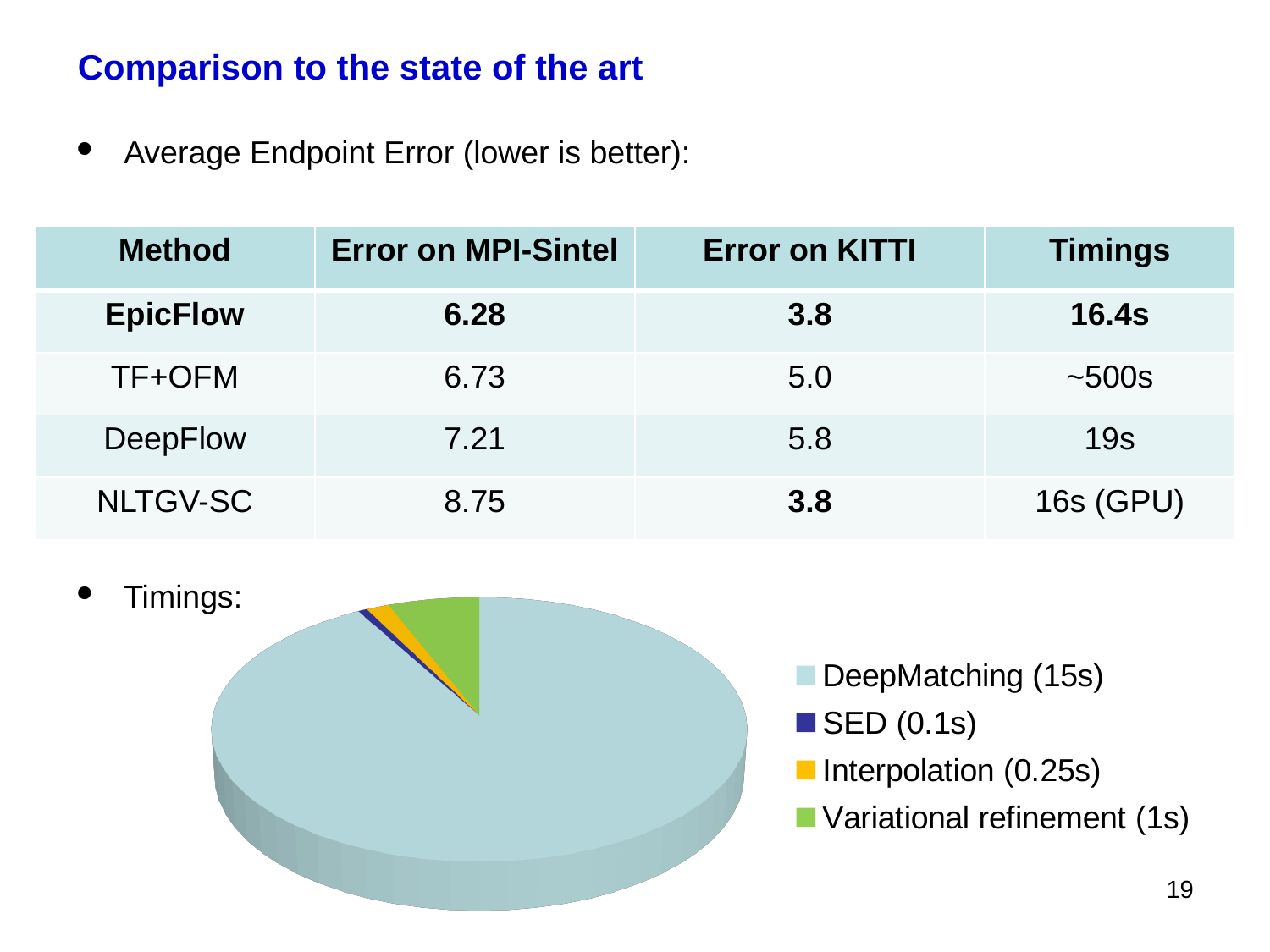
In the timings pie chart, how many slices (categories) does the legend list? 4 What kind of chart is shown under "Timings:" on the slide? pie chart In the timings pie chart, what is the time given for DeepMatching? 15s In the timings pie chart, what is the time given for Variational refinement? 1s In the timings pie chart, what is the time given for SED? 0.1s In the timings pie chart, what is the time given for Interpolation? 0.25s In the timings pie chart, which component takes the most time? DeepMatching In the timings pie chart, which legend entry is shown in green? Variational refinement (1s) In the timings pie chart, what colour is the DeepMatching slice? light blue In the timings pie chart, which component takes the least time? SED In the timings pie chart, how much longer does DeepMatching take than Variational refinement? 14s In the timings pie chart, which takes longer, Interpolation or Variational refinement? Variational refinement